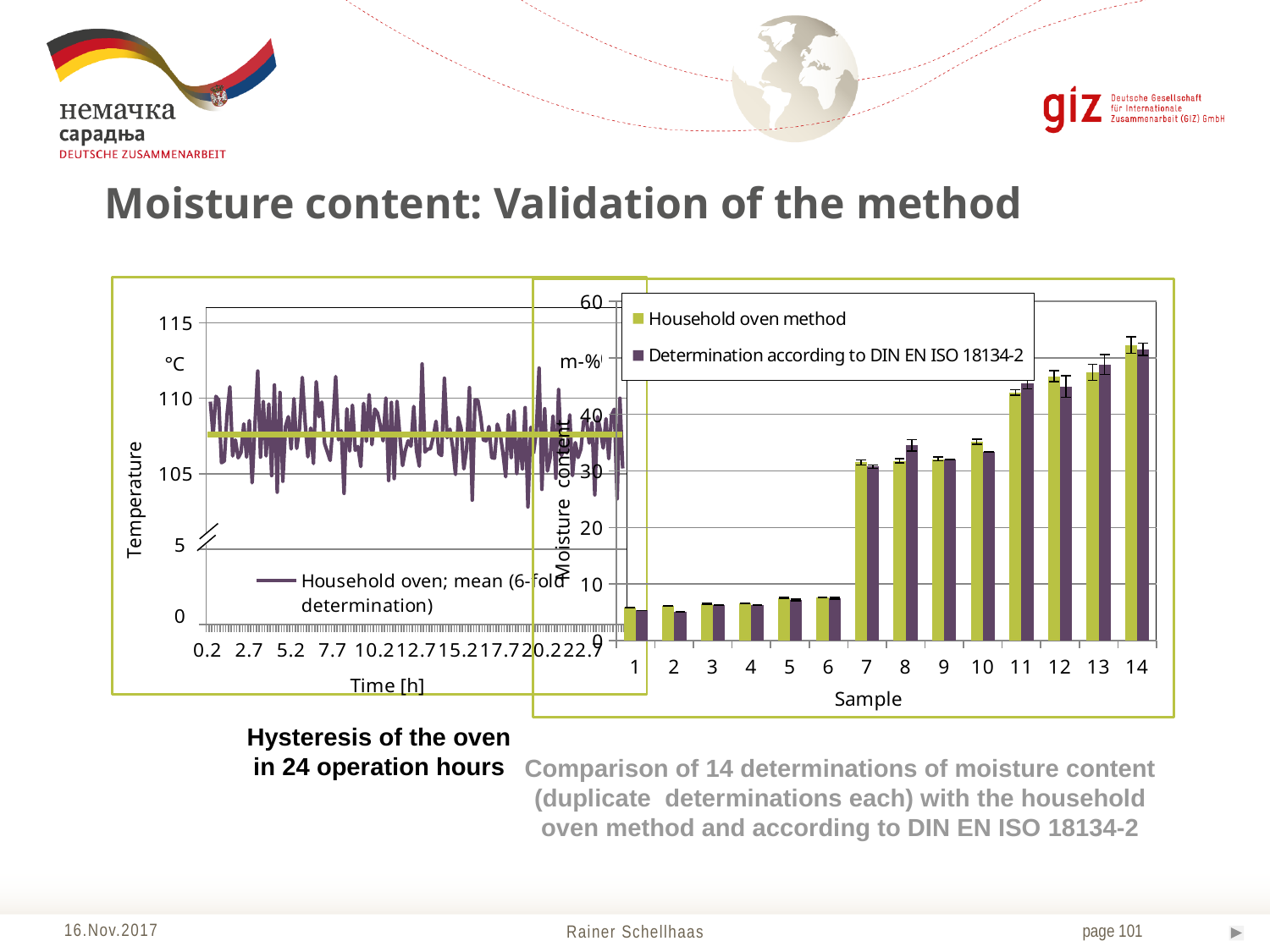
What kind of chart is the left-hand chart with the x axis labelled 'Time [h]'? line chart In the right-hand bar chart, how many series does the legend list? 2 In the right-hand bar chart, which sample has the highest moisture content? 14 In the right-hand bar chart, is the Household oven method value for sample 6 greater or less than 10? less In the right-hand bar chart, which has the larger Household oven method value, sample 7 or sample 11? sample 11 In the right-hand bar chart, is the Household oven method value for sample 11 greater or less than 40? greater In the right-hand bar chart, how many samples are shown on the x axis? 14 In the right-hand bar chart, is the Household oven method value for sample 14 greater or less than 50? greater In the left-hand line chart, what is the label of the y axis? Temperature What kind of chart is the right-hand chart with the x axis labelled 'Sample'? bar chart In the right-hand bar chart, do the moisture content values generally rise or fall from sample 1 to sample 14? rise